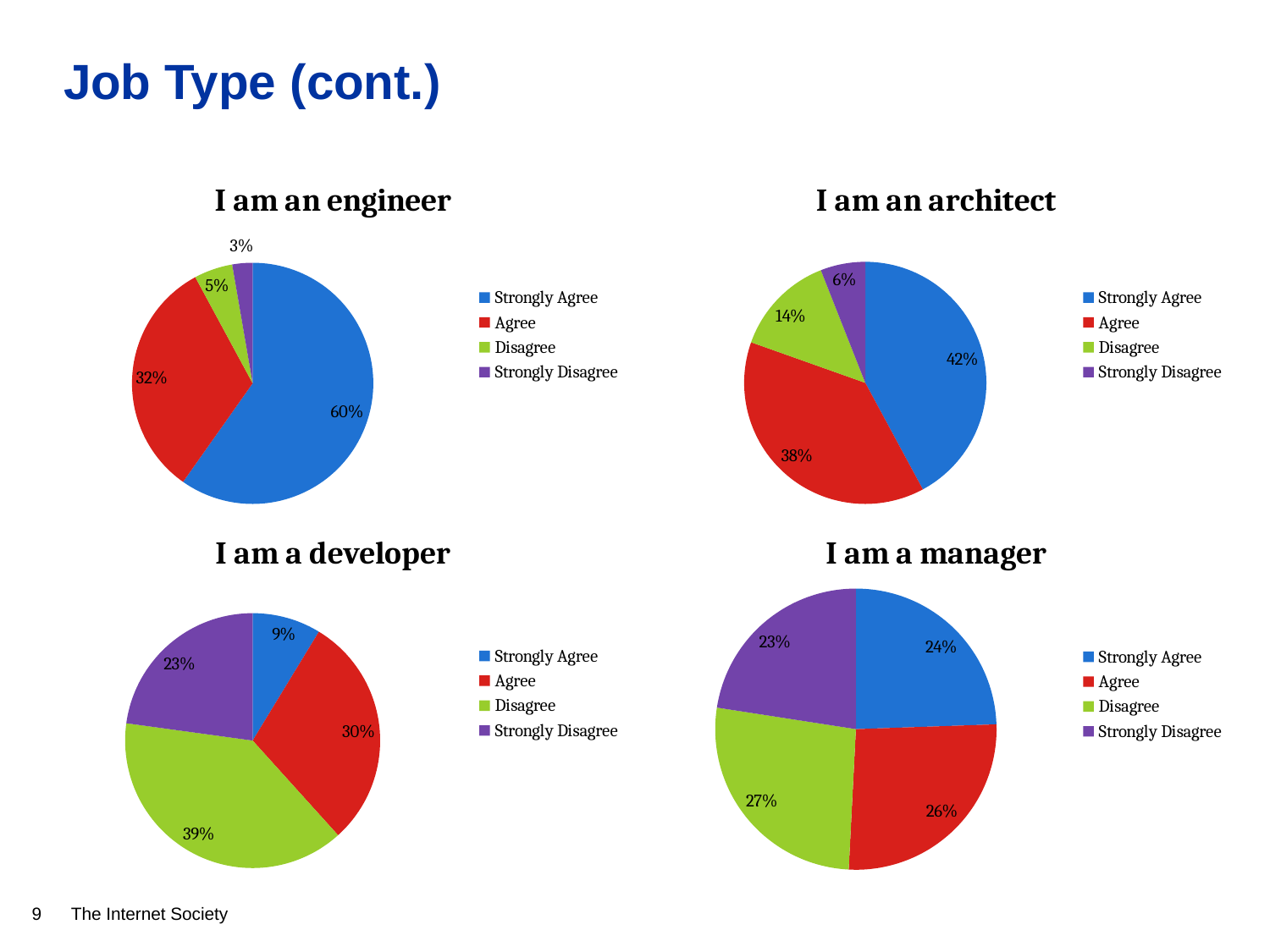
In the 'I am an architect' chart, what percentage of respondents chose Agree? 38% In the 'I am an architect' chart, what is the difference in percentage points between Strongly Agree and Disagree? 28 In the 'I am a developer' chart, which is larger: the share for Agree or the share for Strongly Disagree? Agree How many slices does the 'I am a manager' pie chart have? 4 In the 'I am a manager' chart, what percentage of respondents chose Strongly Disagree? 23% In the 'I am an engineer' chart, what percentage of respondents chose Strongly Agree? 60% In the 'I am an engineer' chart, which response has the smallest share? Strongly Disagree In the 'I am a developer' chart, what colour represents Disagree? Green In the 'I am a developer' chart, which response has the largest share? Disagree In the 'I am a developer' chart, what percentage of respondents chose Disagree? 39% What type of chart is used for 'I am an architect'? Pie chart In the 'I am an engineer' chart, what is the combined share of Strongly Agree and Agree? 92%